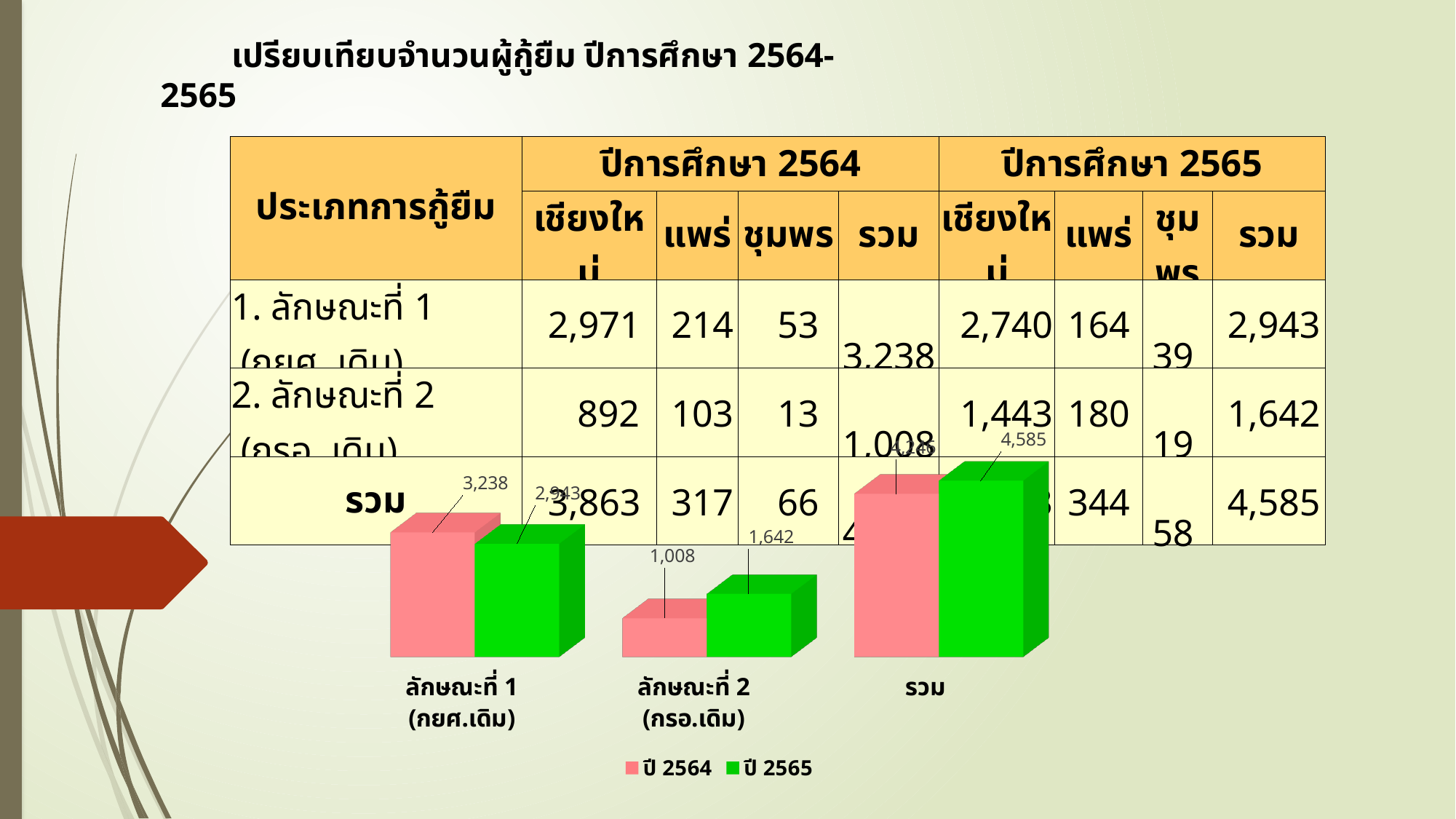
What is the value for ปี 2565 in the category ลักษณะที่ 2 (กรอ.เดิม)? 1,642 Which category has the lowest value for the ปี 2564 series? ลักษณะที่ 2 (กรอ.เดิม) What is the value for ปี 2565 in the category รวม? 4,585 What kind of chart is shown on the slide? bar chart For ลักษณะที่ 2 (กรอ.เดิม), which series has the larger value, ปี 2564 or ปี 2565? ปี 2565 What is the value for ปี 2565 in the category ลักษณะที่ 1 (กยศ.เดิม)? 2,943 What is the value for ปี 2564 in the category ลักษณะที่ 1 (กยศ.เดิม)? 3,238 How many series does the chart legend list? 2 What is the difference between the ปี 2564 and ปี 2565 values for ลักษณะที่ 1 (กยศ.เดิม)? 295 How many categories are plotted along the x axis of the chart? 3 What is the value for ปี 2564 in the category ลักษณะที่ 2 (กรอ.เดิม)? 1,008 What is the difference between the ปี 2565 and ปี 2564 values for ลักษณะที่ 2 (กรอ.เดิม)? 634